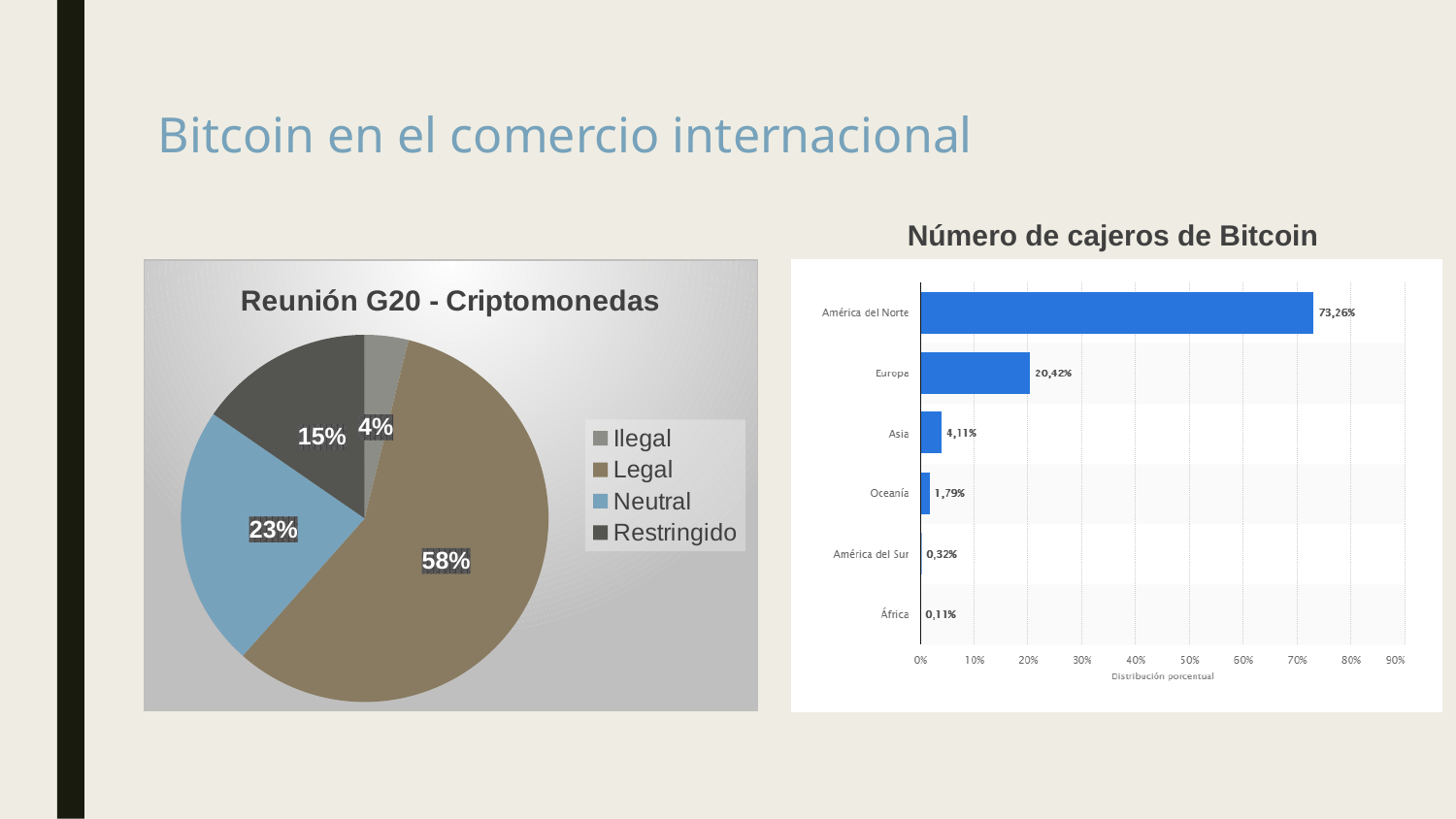
In the 'Número de cajeros de Bitcoin' chart, what is the value for Oceanía? 1,79% What kind of chart is 'Número de cajeros de Bitcoin'? Bar chart In the 'Reunión G20 - Criptomonedas' chart, what share of the pie is Neutral? 23% In the 'Número de cajeros de Bitcoin' chart, which region has the highest value? América del Norte What kind of chart is 'Reunión G20 - Criptomonedas'? Pie chart In the 'Número de cajeros de Bitcoin' chart, what is the value for Europa? 20,42% In the 'Reunión G20 - Criptomonedas' chart, what share of the pie is Legal? 58% In the 'Reunión G20 - Criptomonedas' chart, which category has the smallest slice? Ilegal In the 'Número de cajeros de Bitcoin' chart, how many regions are shown? 6 In the 'Reunión G20 - Criptomonedas' chart, what is the difference between the Restringido and Ilegal shares? 11% In the 'Número de cajeros de Bitcoin' chart, which region has the lowest value? África In the 'Reunión G20 - Criptomonedas' chart, how many entries does the legend list? 4